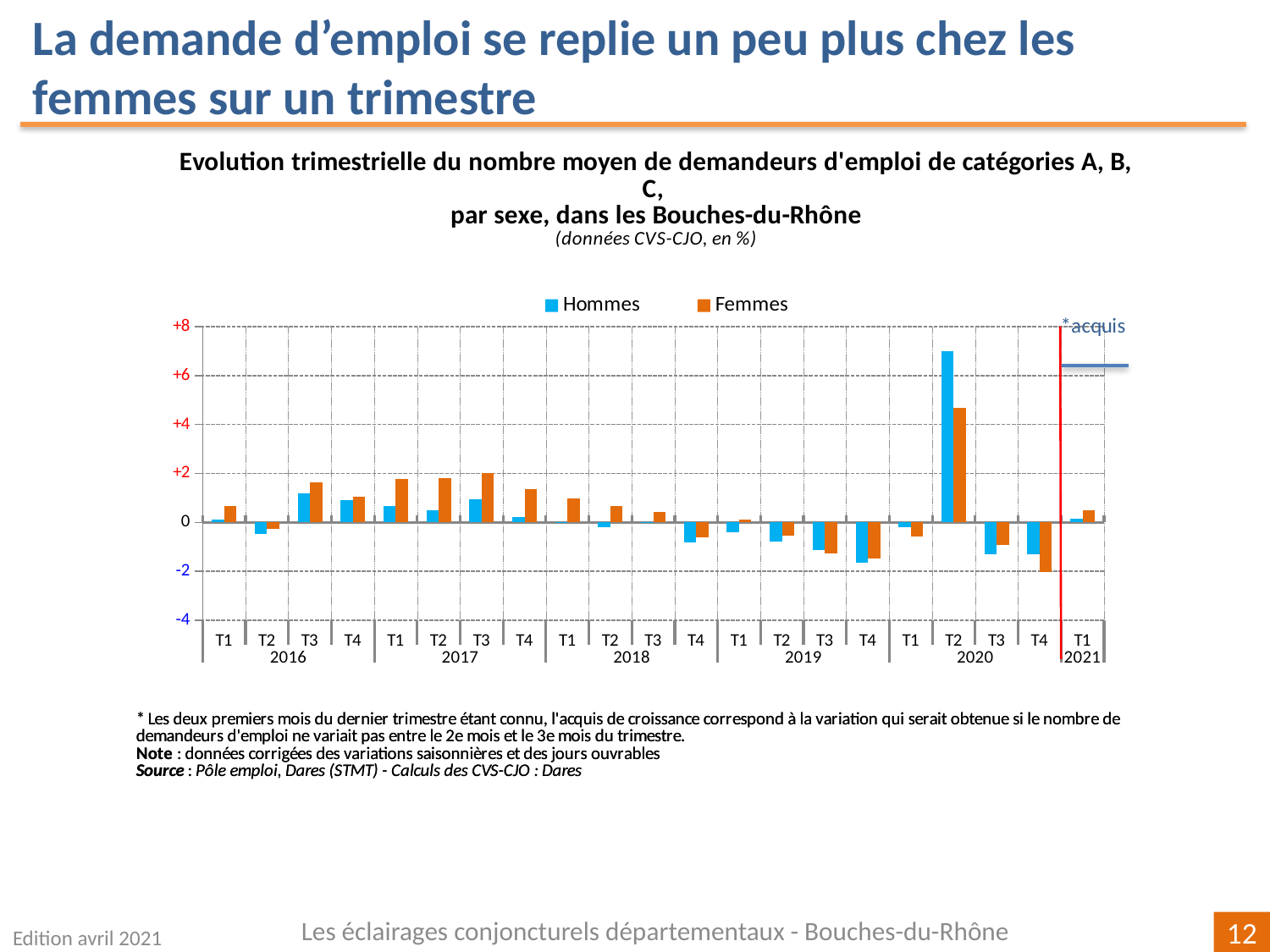
Which quarter has the highest value for Hommes? T2 2020 What kind of chart is shown on the slide? bar chart How many quarters are plotted along the x axis? 21 Is the value for Hommes in T2 2020 greater or less than +6? greater Which quarter has the lowest value for Femmes? T4 2020 Which quarter has the highest value for Femmes? T2 2020 How many series does the legend list? 2 Is the value for Femmes in T2 2020 greater or less than +4? greater In T2 2020, which series has the larger value, Hommes or Femmes? Hommes Which colour represents the Femmes series? orange Is the value for Femmes in T4 2020 greater or less than -1? less In T1 2021, which series has the larger value, Hommes or Femmes? Femmes